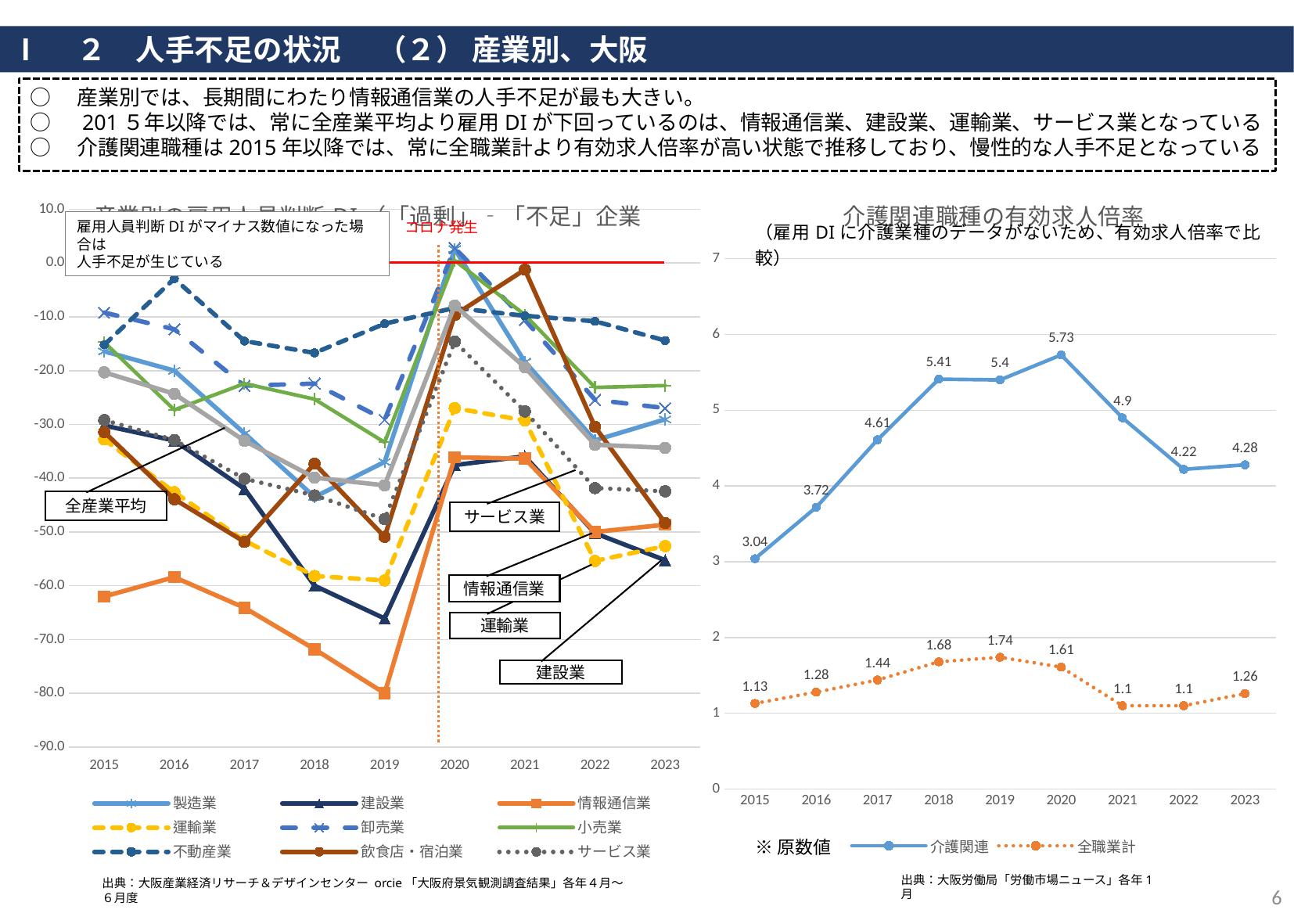
In the right chart (介護関連職種の有効求人倍率), how many series does the legend list? 2 In the right chart (介護関連職種の有効求人倍率), in which year is the 介護関連 value lowest? 2015 In the right chart (介護関連職種の有効求人倍率), what is the difference between the 介護関連 value in 2020 and in 2015? 2.69 In the right chart (介護関連職種の有効求人倍率), what is the value for 全職業計 in 2019? 1.74 In the right chart (介護関連職種の有効求人倍率), which is larger in 2023: the 介護関連 value or the 全職業計 value? 介護関連 In the left chart (employment DI by industry), how many series does the legend list? 9 What kind of chart is the left chart showing the employment DI by industry? line chart In the right chart (介護関連職種の有効求人倍率), in which year is the 全職業計 value highest? 2019 In the right chart (介護関連職種の有効求人倍率), how many years are plotted on the x axis? 9 In the right chart (介護関連職種の有効求人倍率), what is the value for 介護関連 in 2020? 5.73 In the right chart (介護関連職種の有効求人倍率), does the 介護関連 value rise or fall from 2015 to 2018? rise In the left chart (employment DI by industry), is the value for 情報通信業 in 2019 greater or less than -70.0? less